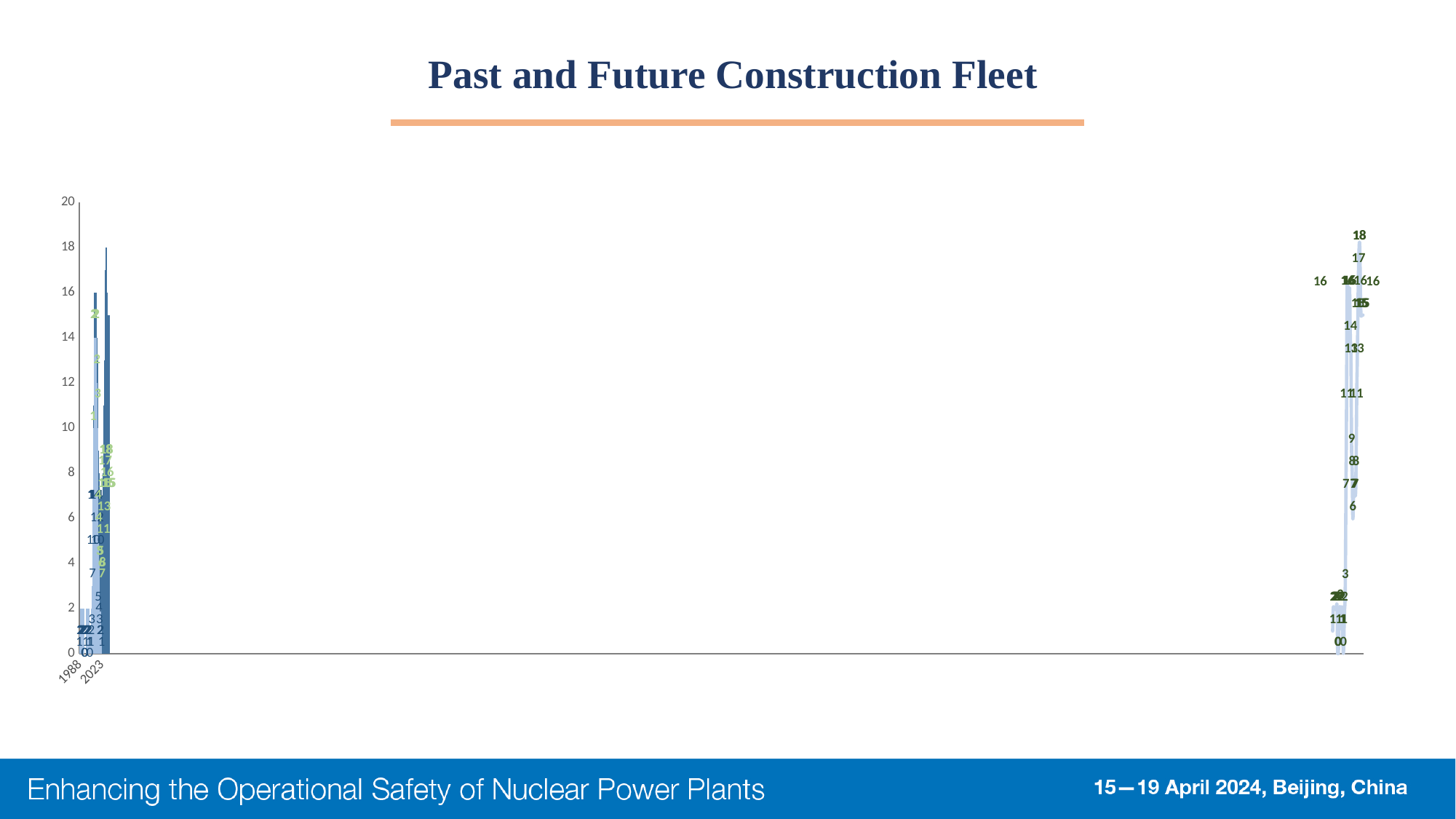
What is the first year label shown on the x axis of the chart? 1988 What is the lowest value labelled on the chart? 0 What is the title of the chart? Past and Future Construction Fleet What kind of chart is shown on the slide? bar chart What is the highest value labelled on the chart? 18 Is the tallest bar on the chart greater or less than 10? greater